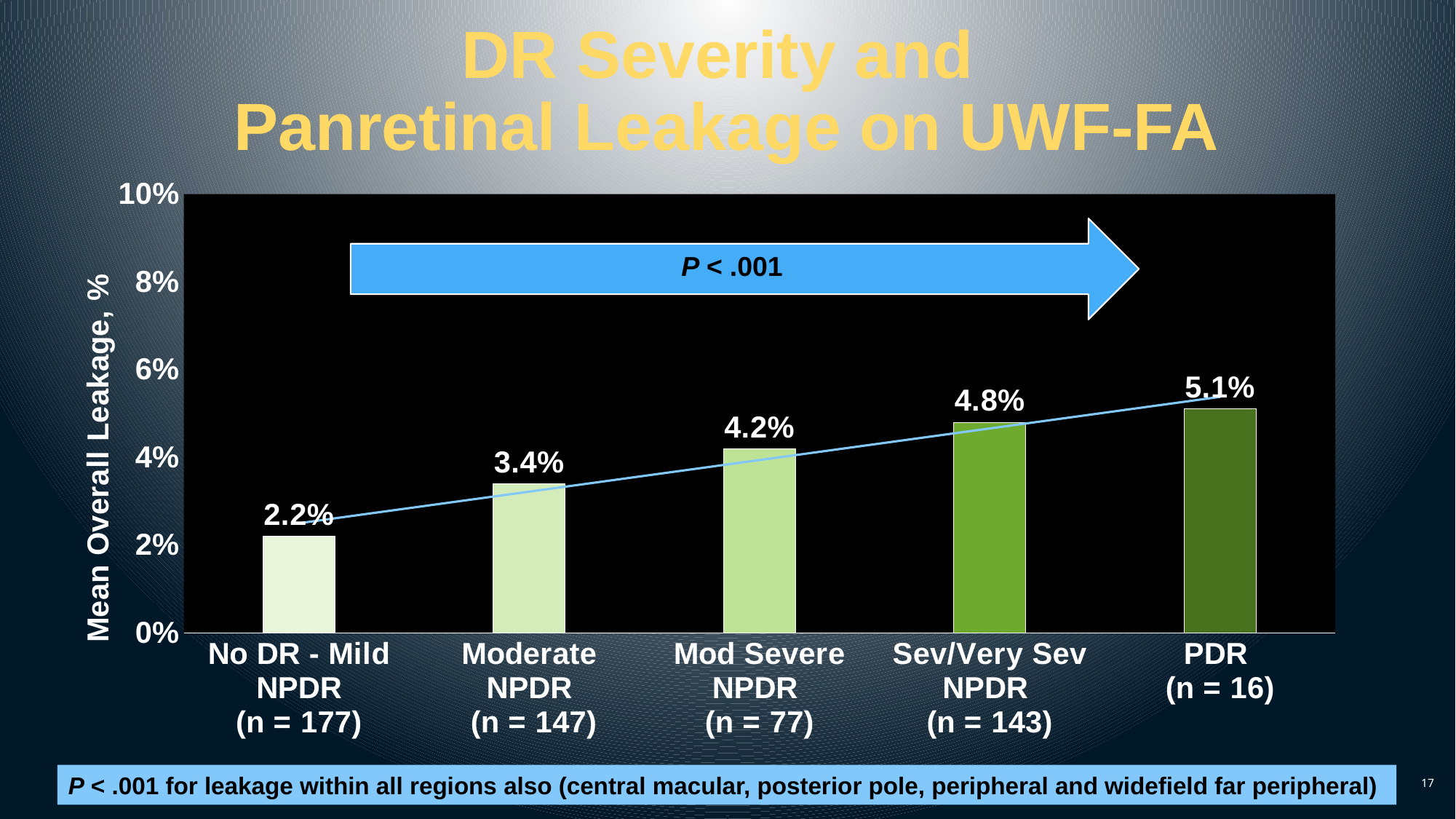
What kind of chart is shown on the slide? Bar chart What is the mean overall leakage for PDR? 5.1% Which DR severity category has the lowest mean overall leakage? No DR - Mild NPDR Which has a higher mean overall leakage, Moderate NPDR or Mod Severe NPDR? Mod Severe NPDR What is the mean overall leakage for Moderate NPDR? 3.4% What is the difference in mean overall leakage between Sev/Very Sev NPDR and Mod Severe NPDR? 0.6% What is the mean overall leakage for No DR - Mild NPDR? 2.2% Which DR severity category has the highest mean overall leakage? PDR How many DR severity categories are shown on the x axis? 5 Is the mean overall leakage for Sev/Very Sev NPDR greater or less than 4%? greater Do the mean overall leakage values rise or fall as DR severity increases along the x axis? Rise What is the difference in mean overall leakage between PDR and No DR - Mild NPDR? 2.9%